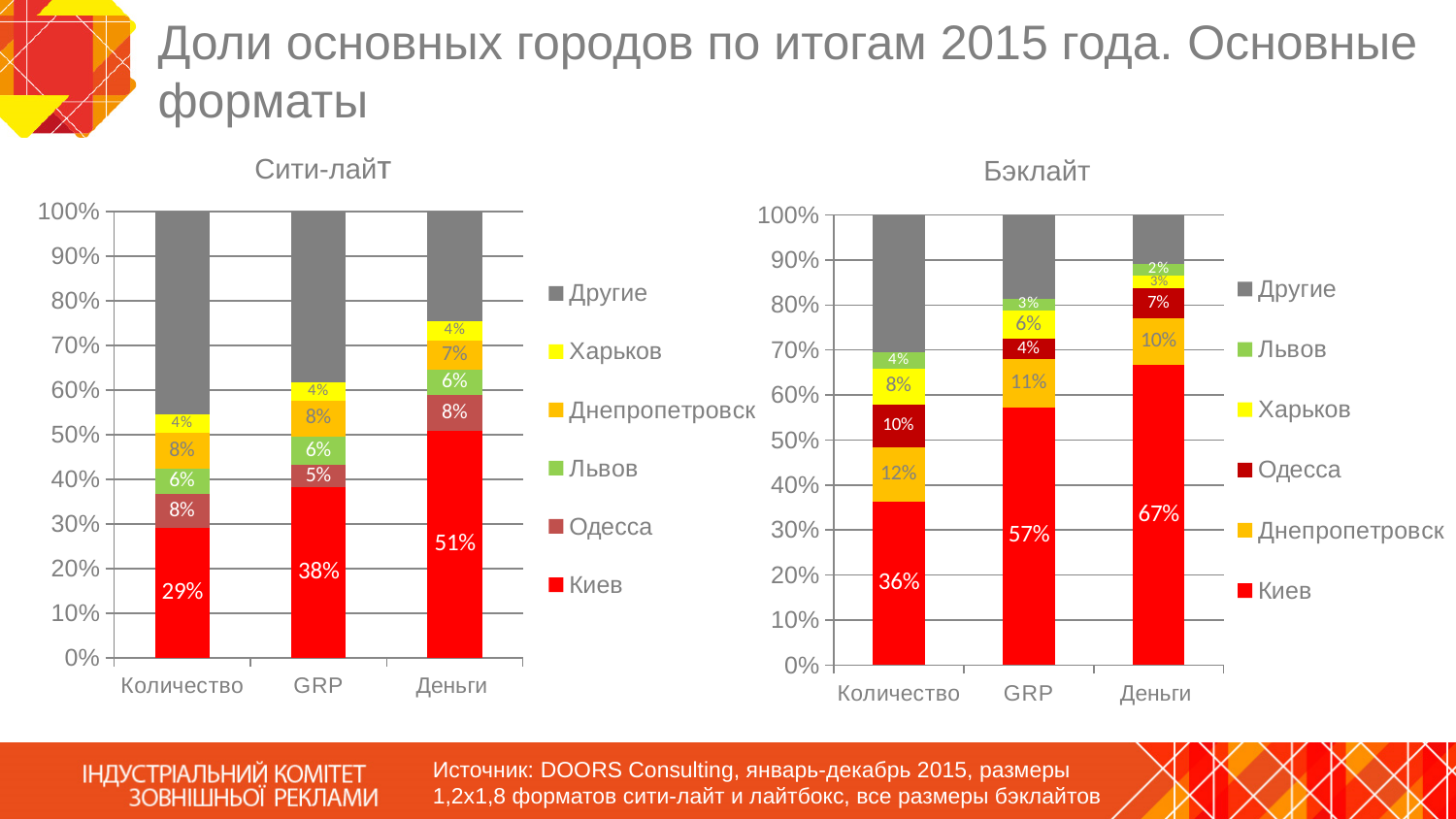
On the Бэклайт chart, in which category is the Киев share lowest? Количество How many series does the legend of the Бэклайт chart list? 6 What kind of chart is the Сити-лайт chart? Stacked bar chart On the Сити-лайт chart, what is the value for Одесса in the GRP bar? 5% On the Сити-лайт chart, what is the value for Киев in the Деньги bar? 51% On the Бэклайт chart, what is the value for Киев in the GRP bar? 57% On the Бэклайт chart, which is larger: Одесса in Количество or Одесса in Деньги? Одесса in Количество On the Бэклайт chart, is the Киев value for Деньги greater or less than 60%? greater On the Сити-лайт chart, in which category is the Киев share highest? Деньги How many categories are shown on the x axis of the Сити-лайт chart? 3 On the Бэклайт chart, what is the value for Днепропетровск in the Количество bar? 12% On the Сити-лайт chart, what is the difference between the Киев values for Деньги and Количество? 22 percentage points